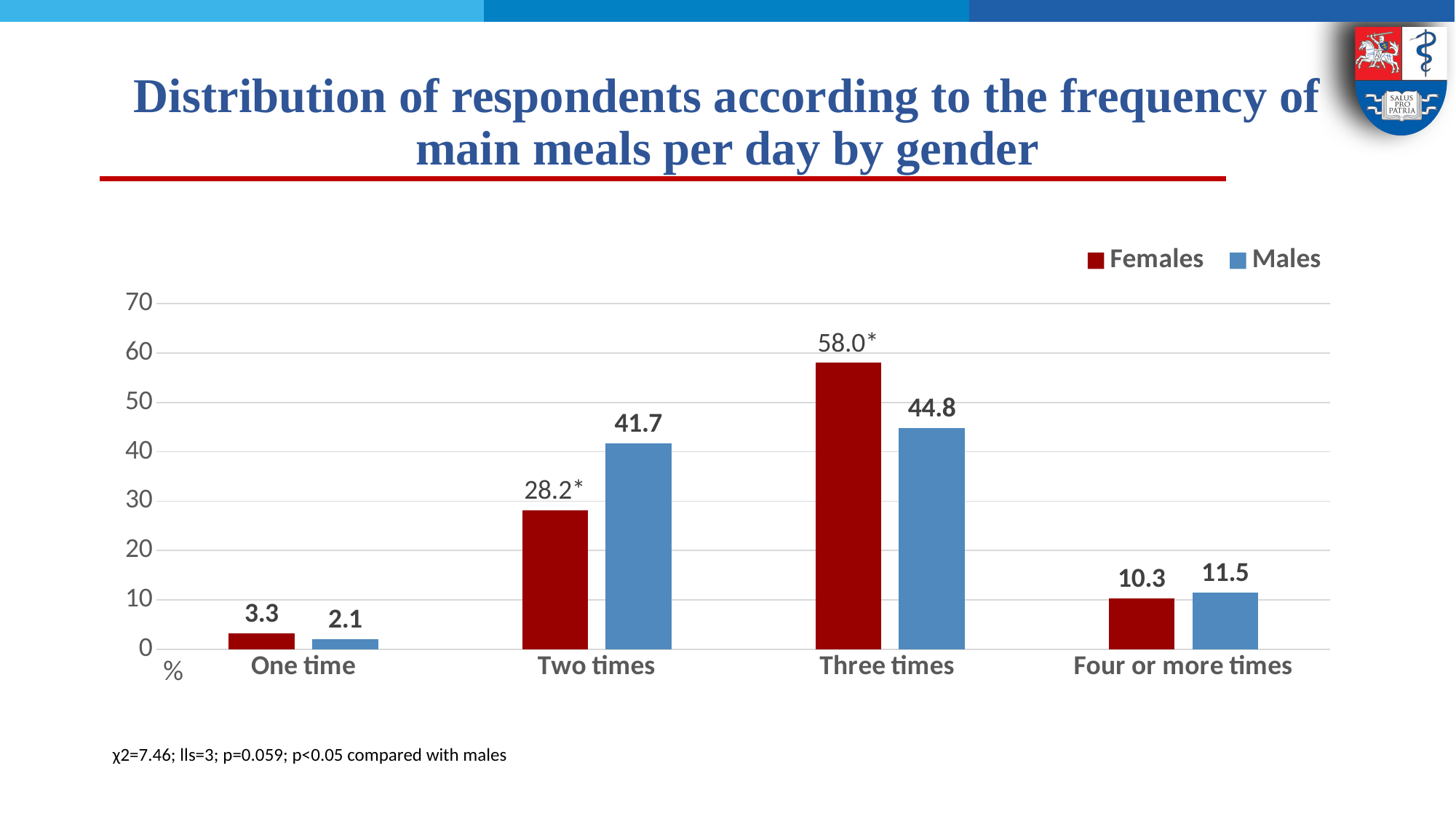
How many series does the legend list? 2 Which colour represents Females in the chart? Dark red What kind of chart is shown on the slide? Bar chart Which category has the lowest value for Males? One time Which category has the highest value for Females? Three times What is the value for Males in the Two times category? 41.7 How many categories are shown on the x axis? 4 What is the value for Females in the Three times category? 58.0 In the Three times category, which is larger, the Females value or the Males value? Females What is the value for Females in the One time category? 3.3 What is the value for Males in the Four or more times category? 11.5 What is the difference between the Males and Females values in the Two times category? 13.5